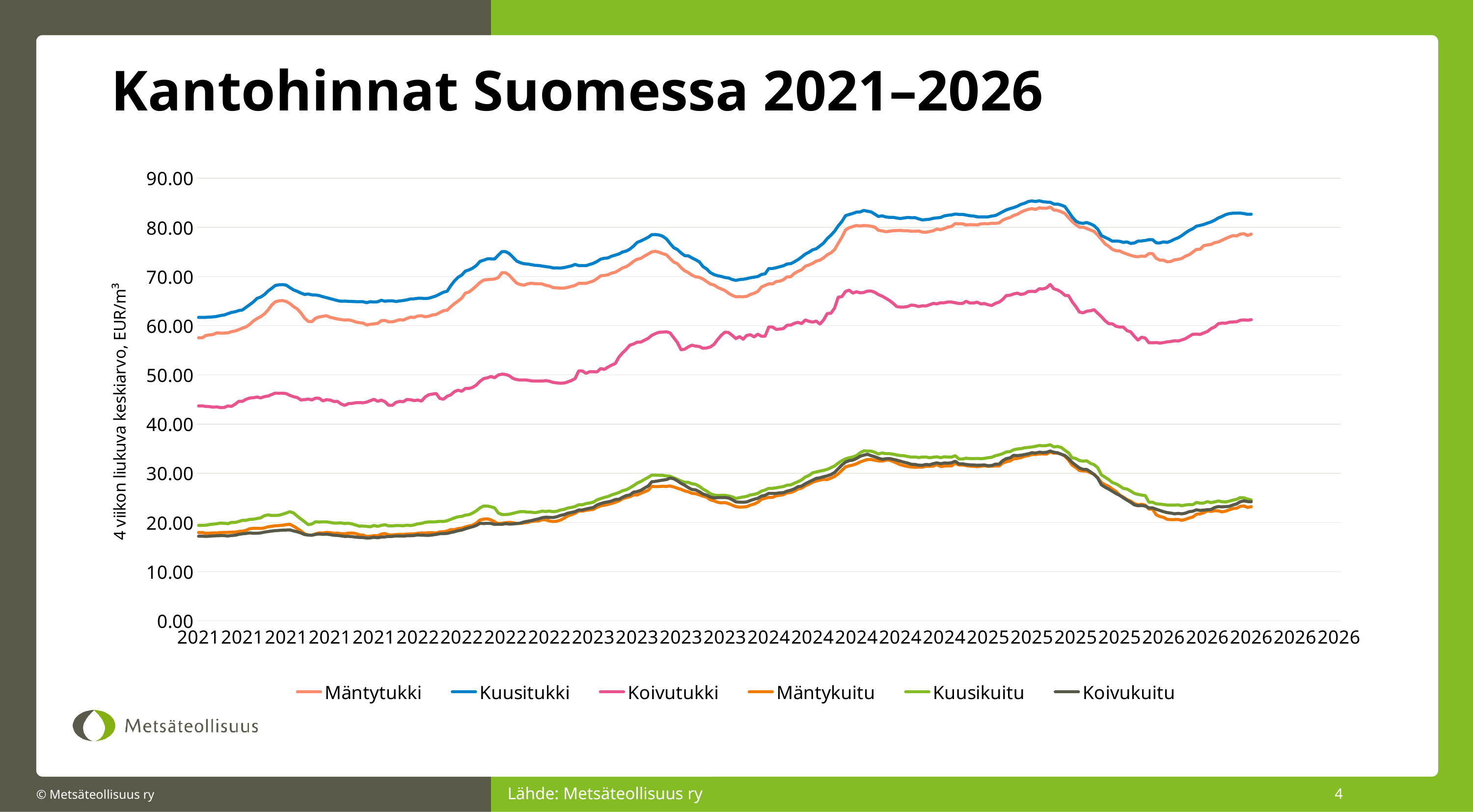
Is the value for Koivutukki at the start of 2021 greater or less than 50? less How many series does the legend list? 6 Which series has the highest values across the whole period? Kuusitukki Is the highest value reached by Kuusikuitu greater or less than 40? less What is the label on the vertical axis? 4 viikon liukuva keskiarvo, EUR/m³ What kind of chart is shown on the slide? line chart Is the value for Mäntytukki at the start of 2021 greater or less than 60? less Which is larger throughout the period, Kuusitukki or Mäntytukki? Kuusitukki What is the title of the chart? Kantohinnat Suomessa 2021–2026 Does the Koivutukki series rise or fall from 2021 to 2024? rise Which is larger throughout the period, Mäntytukki or Koivutukki? Mäntytukki